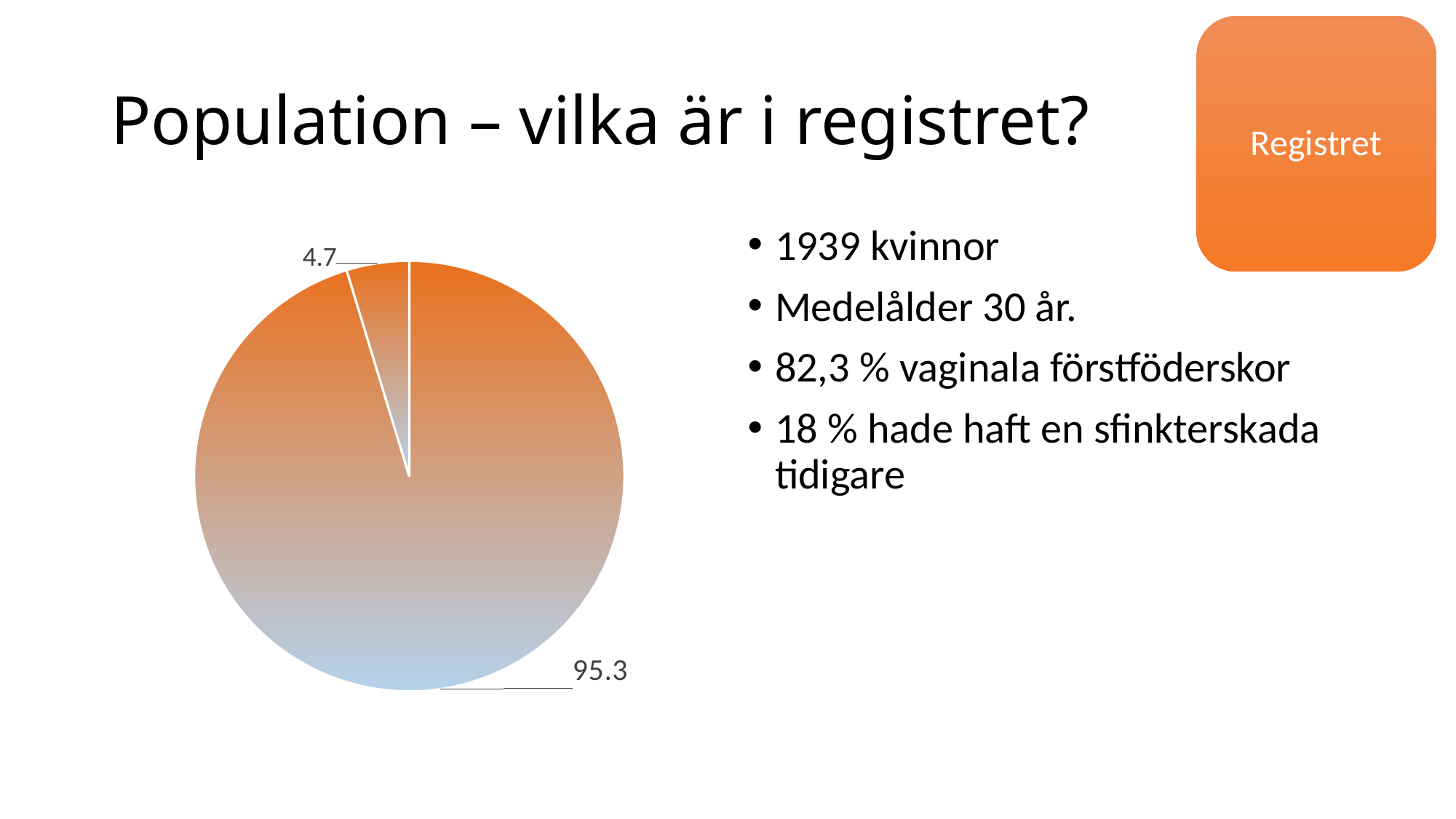
What is the value of the largest slice in the pie chart? 95.3 What is the difference between the two slice values in the pie chart? 90.6 What do the two slice values in the pie chart add up to? 100 Is the value of the large slice in the pie chart greater or less than 90? greater Does the pie chart have a legend? No What is the value of the smallest slice in the pie chart? 4.7 What is the title of the slide containing the pie chart? Population – vilka är i registret? Is the value of the small slice in the pie chart greater or less than 10? less What kind of chart is shown on the slide? pie chart How many slices does the pie chart have? 2 Which slice is larger in the pie chart, the one labelled 4.7 or the one labelled 95.3? 95.3